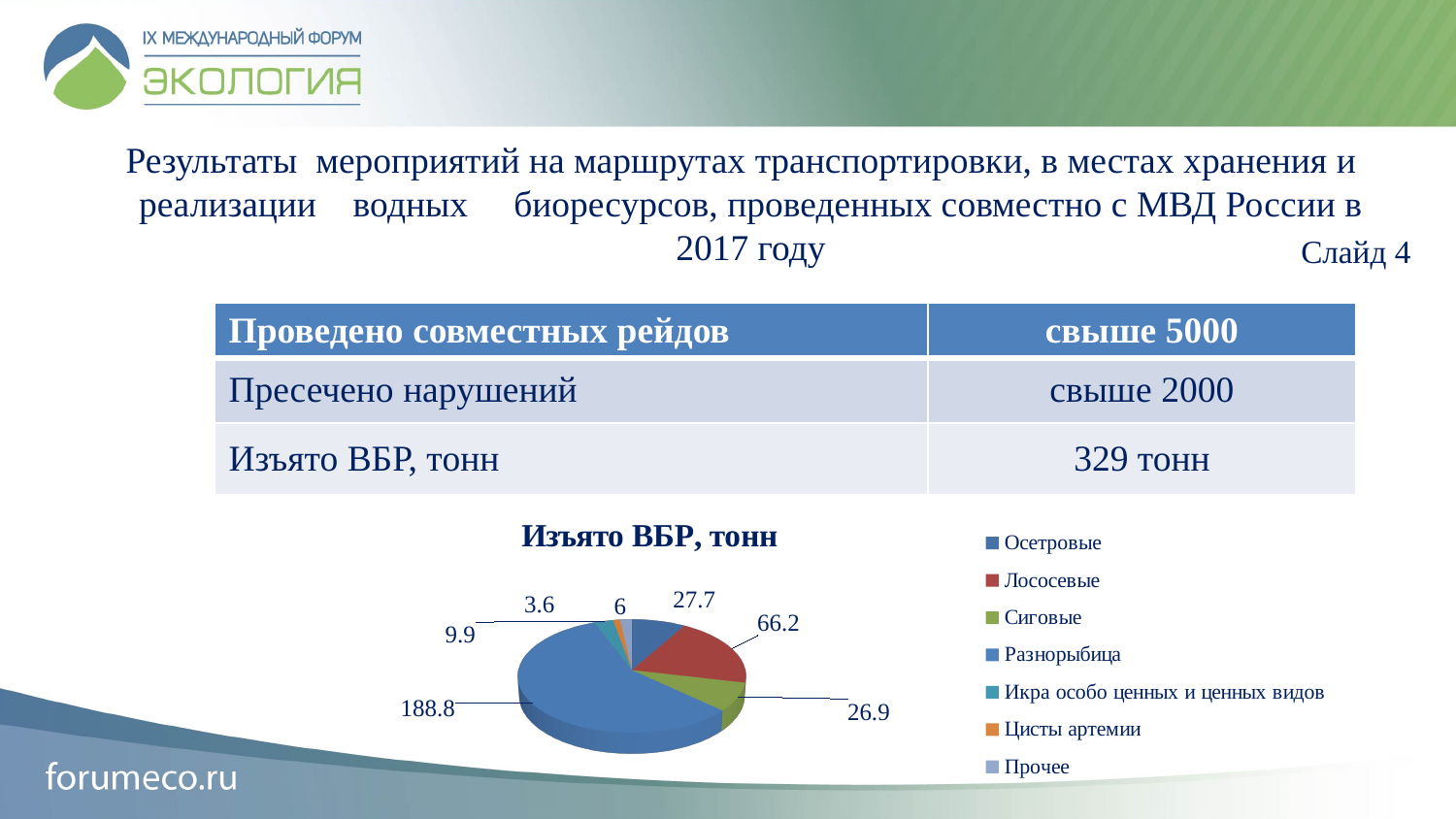
What is the value for Цисты артемии in the pie chart? 3.6 What is the value for Осетровые in the pie chart? 27.7 What is the title of the pie chart? Изъято ВБР, тонн What colour is the Лососевые slice in the pie chart? red Which category has the smallest slice in the pie chart? Цисты артемии What is the difference between the values for Разнорыбица and Лососевые? 122.6 What kind of chart is shown on the slide? pie chart Which category has the largest slice in the pie chart? Разнорыбица What is the value for Лососевые in the pie chart? 66.2 How many categories does the pie chart's legend list? 7 Which is larger, the value for Сиговые or the value for Осетровые? Осетровые What is the value for Разнорыбица in the pie chart? 188.8